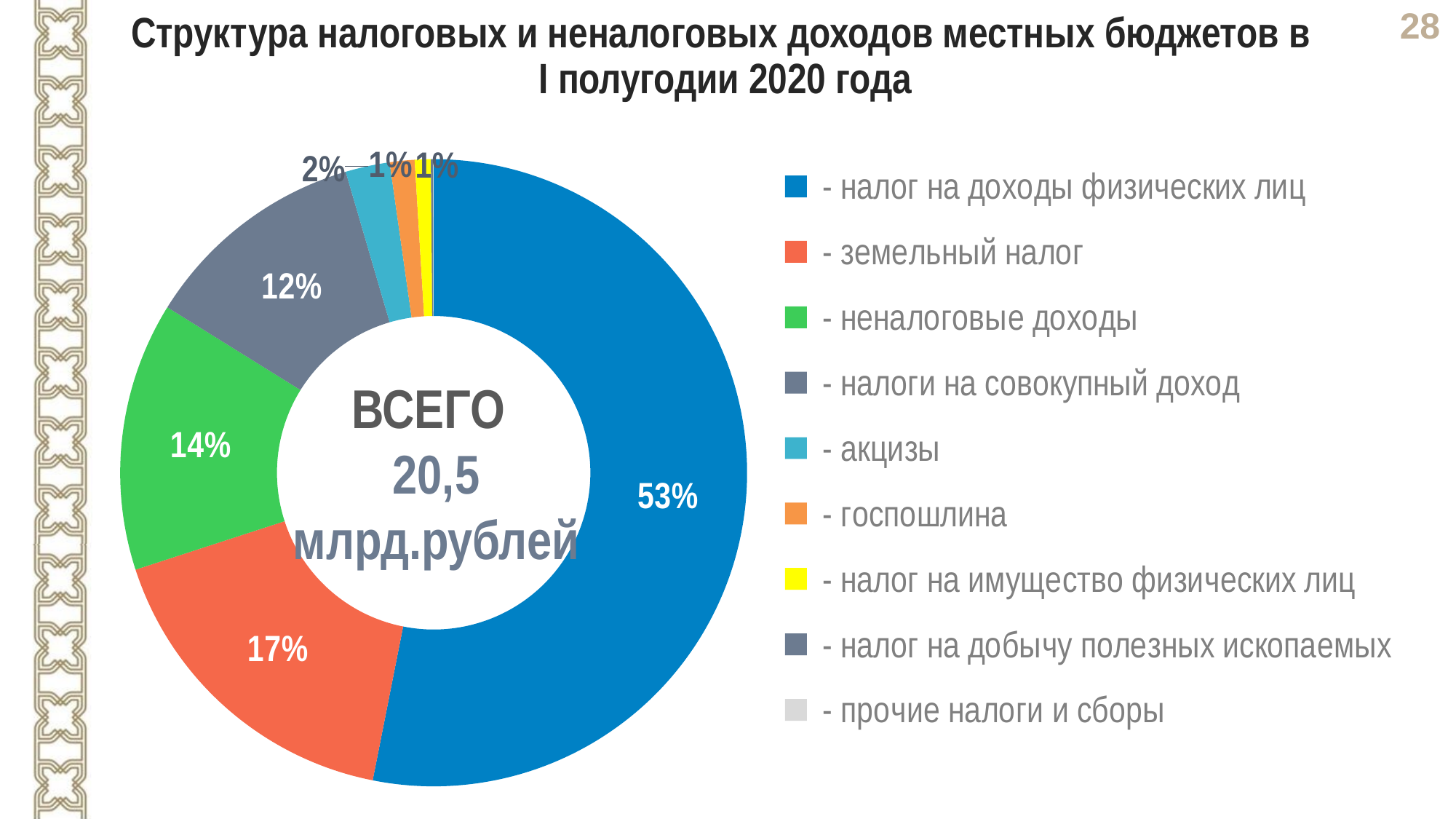
How many categories does the legend list? 9 What total value is printed in the centre of the chart? 20,5 млрд.рублей What percentage is shown for неналоговые доходы? 14% Which is larger: the share for неналоговые доходы or the share for налоги на совокупный доход? неналоговые доходы What is the difference in percentage points between земельный налог and неналоговые доходы? 3 What percentage is shown for земельный налог? 17% What percentage is shown for акцизы? 2% Which category has the largest share of the chart? налог на доходы физических лиц What colour represents земельный налог in the chart? orange-red What share of the pie does налог на доходы физических лиц account for? 53% What kind of chart is shown on the slide? pie (doughnut) chart What percentage is shown for налоги на совокупный доход? 12%